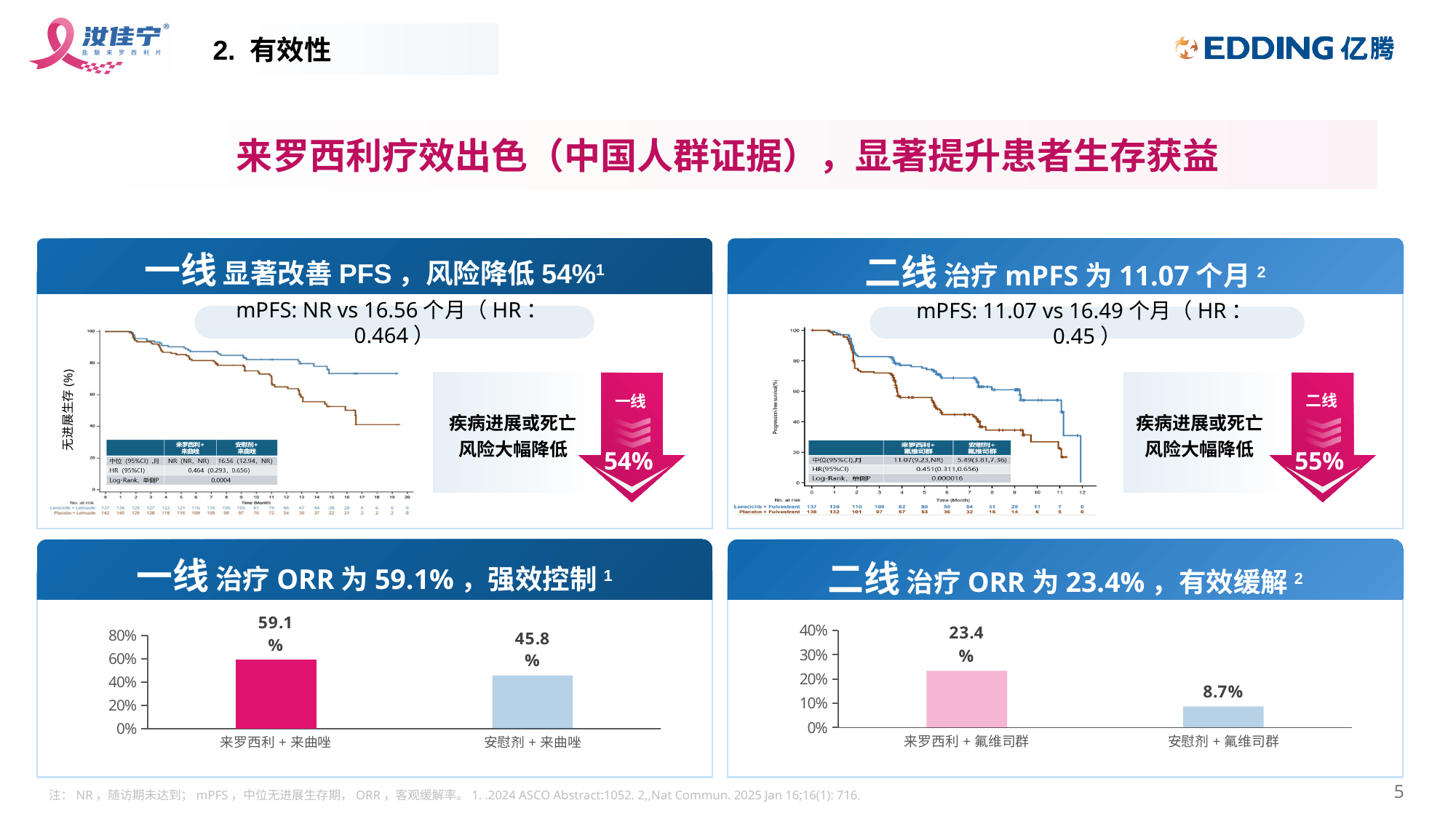
In the bottom-right chart (二线 治疗 ORR), is the value for 来罗西利 + 氟维司群 greater or less than 20%? greater What kind of chart is the bottom-right chart (二线 治疗 ORR)? bar chart How many categories are shown in the bottom-left chart (一线 治疗 ORR)? 2 In the bottom-left chart (一线 治疗 ORR), is the value for 安慰剂 + 来曲唑 greater or less than 60%? less In the bottom-left chart (一线 治疗 ORR), what is the ORR for 安慰剂 + 来曲唑? 45.8% In the bottom-right chart (二线 治疗 ORR), which category has the lowest value? 安慰剂 + 氟维司群 In the bottom-right chart (二线 治疗 ORR), what is the ORR for 安慰剂 + 氟维司群? 8.7% In the bottom-left chart (一线 治疗 ORR), what is the ORR for 来罗西利 + 来曲唑? 59.1% In the bottom-right chart (二线 治疗 ORR), what is the ORR for 来罗西利 + 氟维司群? 23.4% In the bottom-left chart (一线 治疗 ORR), which category has the higher value? 来罗西利 + 来曲唑 In the bottom-right chart (二线 治疗 ORR), what is the difference between the values for 来罗西利 + 氟维司群 and 安慰剂 + 氟维司群? 14.7 percentage points In the bottom-left chart (一线 治疗 ORR), what is the difference between the values for 来罗西利 + 来曲唑 and 安慰剂 + 来曲唑? 13.3 percentage points